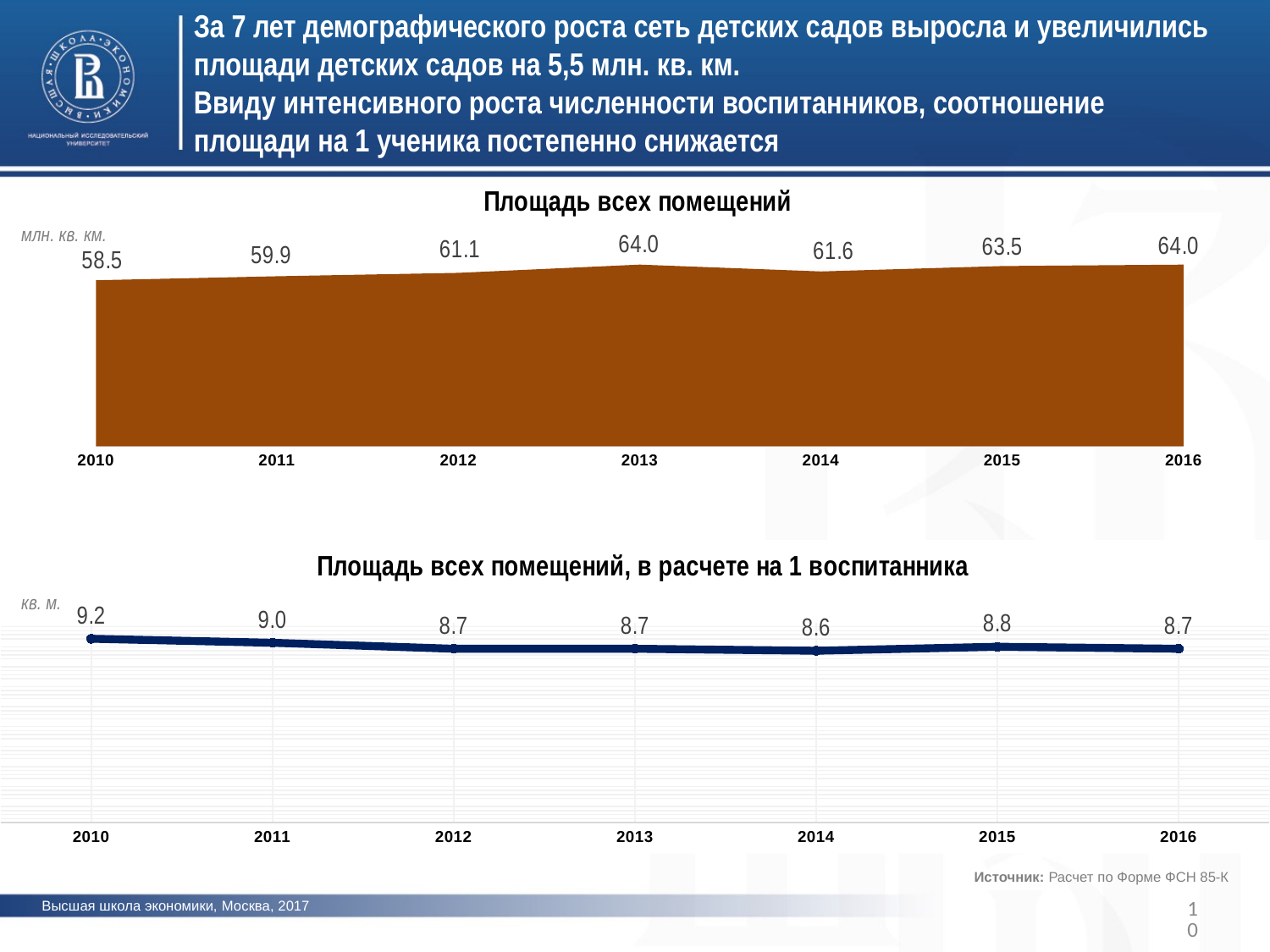
In the chart 'Площадь всех помещений, в расчете на 1 воспитанника', what is the difference between the values for 2010 and 2016? 0.5 In the chart 'Площадь всех помещений, в расчете на 1 воспитанника', what is the value for 2015? 8.8 In the chart 'Площадь всех помещений', what is the value for 2010? 58.5 What kind of chart is the bottom chart 'Площадь всех помещений, в расчете на 1 воспитанника'? line chart In the chart 'Площадь всех помещений, в расчете на 1 воспитанника', which year has the lowest value? 2014 In the chart 'Площадь всех помещений', which year has the lowest value? 2010 In the chart 'Площадь всех помещений', which is larger: the value for 2013 or the value for 2014? 2013 How many years are shown on the x axis of the chart 'Площадь всех помещений'? 7 In the chart 'Площадь всех помещений, в расчете на 1 воспитанника', which year has the highest value? 2010 In the chart 'Площадь всех помещений', what is the difference between the values for 2016 and 2010? 5.5 In the chart 'Площадь всех помещений, в расчете на 1 воспитанника', what is the value for 2010? 9.2 In the chart 'Площадь всех помещений', what is the value for 2014? 61.6